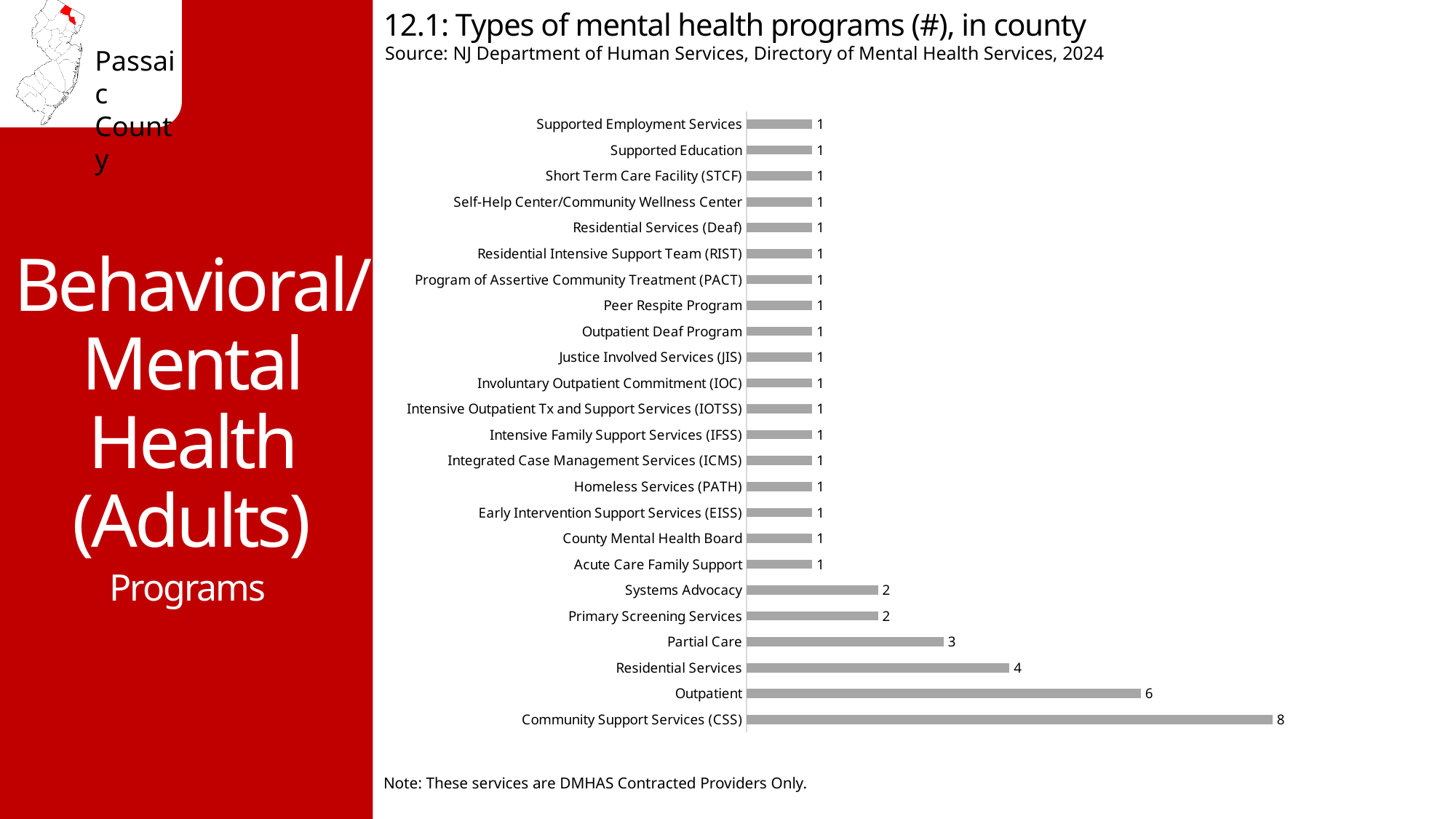
What kind of chart is shown on the slide? Bar chart What is the value for Outpatient? 6 What is the difference between the values for Community Support Services (CSS) and Outpatient? 2 Which is larger, the value for Outpatient or the value for Residential Services? Outpatient Which program type has the highest number of programs? Community Support Services (CSS) What is the value for Residential Services? 4 What is the value for Partial Care? 3 What is the value for Primary Screening Services? 2 What is the title of the chart? 12.1: Types of mental health programs (#), in county What is the difference between the values for Residential Services and Partial Care? 1 What is the value for Community Support Services (CSS)? 8 How many program types are shown in the chart? 24